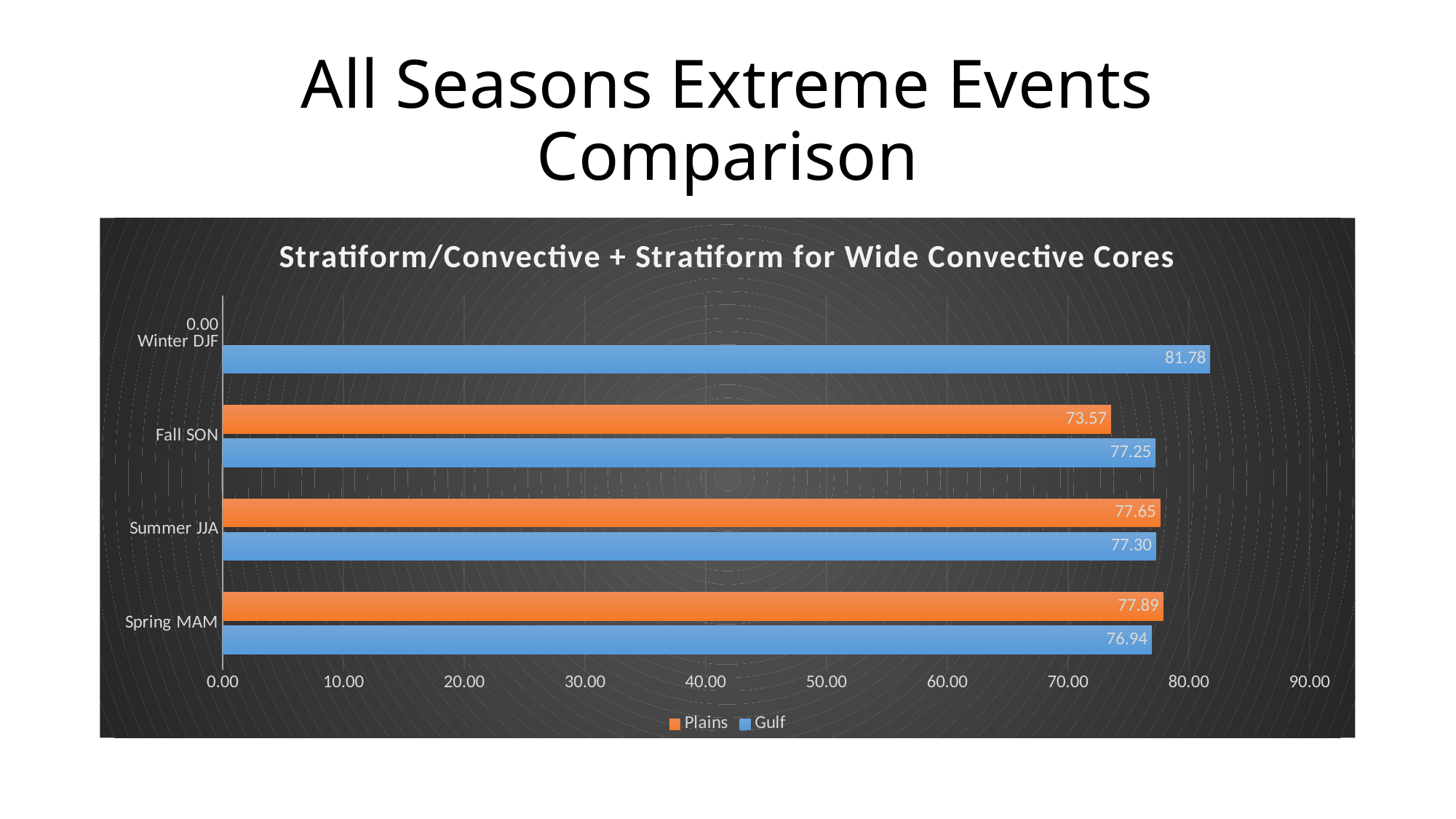
What is the Plains value for Spring MAM? 77.89 What is the difference between the Plains and Gulf values for Fall SON? 3.68 What type of chart is shown? Bar chart How many series does the legend list? 2 What is the Gulf value for Winter DJF? 81.78 Which season has the highest Gulf value? Winter DJF How many seasons are shown on the chart? 4 What is the Gulf value for Summer JJA? 77.30 Which season has the lowest Plains value? Winter DJF What is the Plains value for Winter DJF? 0.00 For Spring MAM, which is larger, the Plains value or the Gulf value? Plains What is the Plains value for Fall SON? 73.57